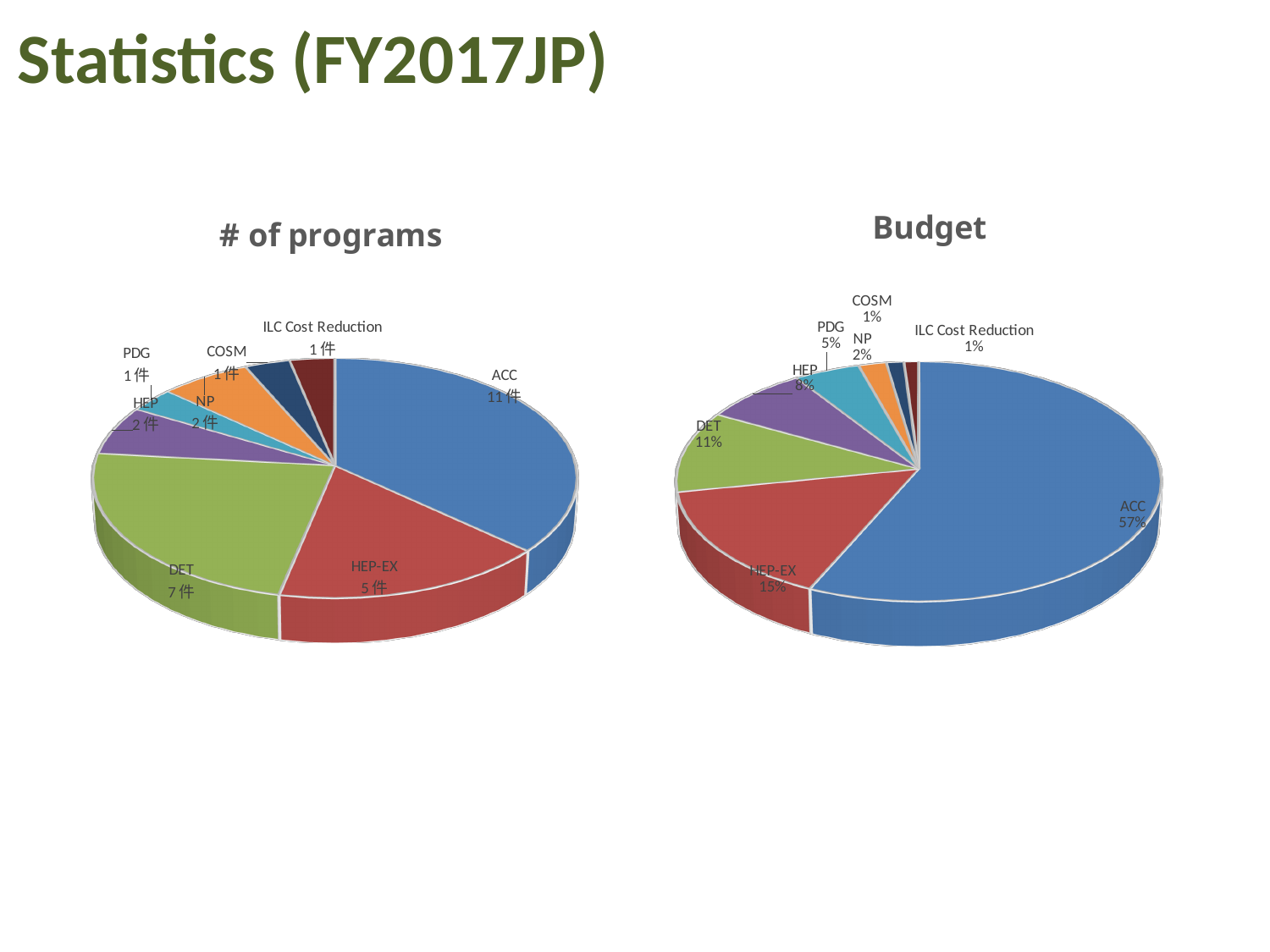
In the "# of programs" chart, how many programs does ACC have? 11件 In the "Budget" chart, what percentage is shown for HEP? 8% What kind of chart is the "Budget" chart? Pie chart In the "# of programs" chart, which category has the most programs? ACC What is the title of the chart on the right side of the slide? Budget In the "# of programs" chart, how many categories are shown? 8 In the "Budget" chart, what is the difference between the HEP-EX and DET percentages? 4% In the "# of programs" chart, what is the difference between the number of programs for ACC and HEP-EX? 6件 In the "# of programs" chart, how many programs does DET have? 7件 In the "Budget" chart, what share of the budget goes to ACC? 57% In the "# of programs" chart, which has more programs, DET or HEP-EX? DET In the "Budget" chart, which category has the largest share? ACC